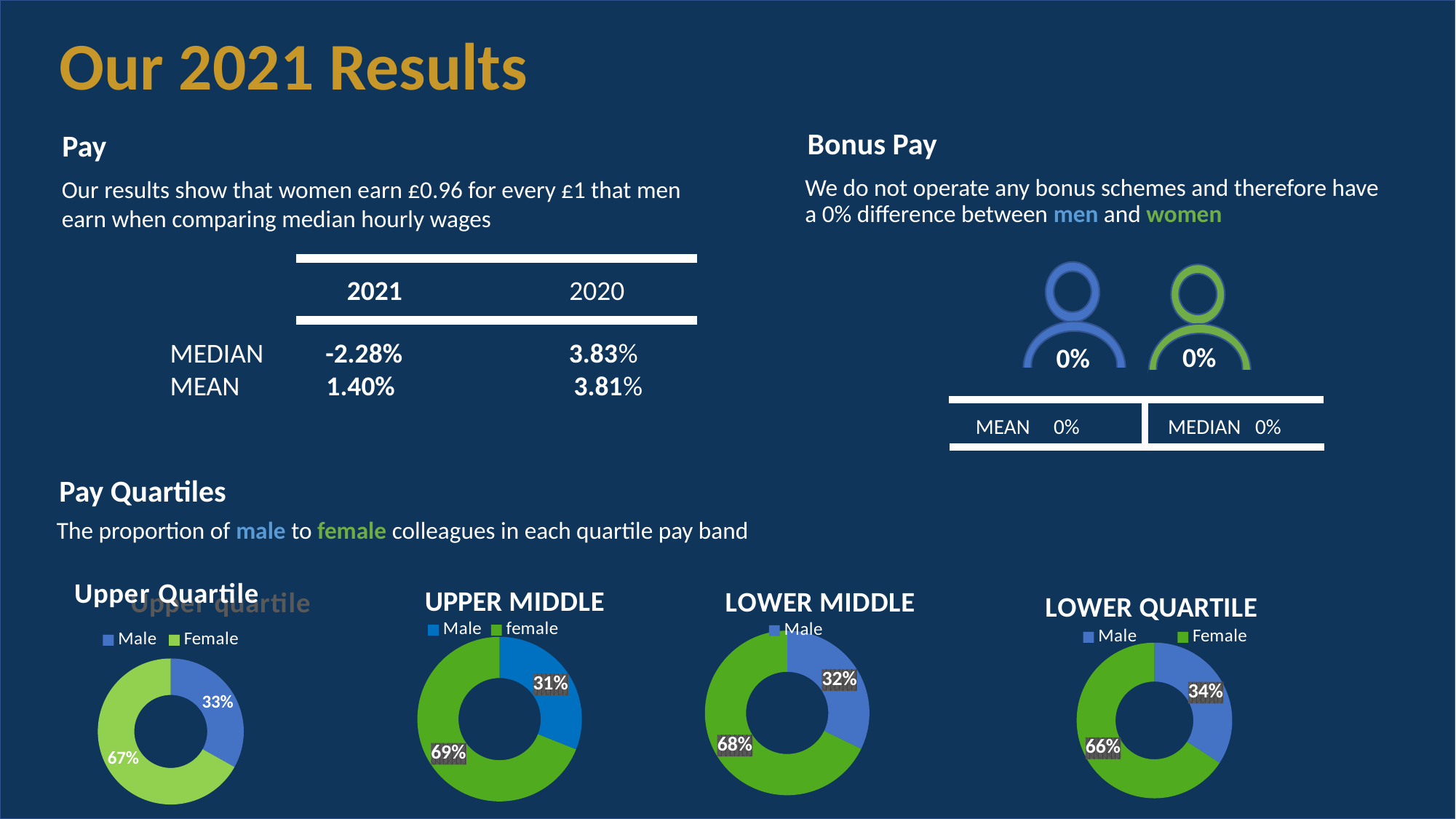
In the LOWER QUARTILE chart, what is the value for Male? 34% In the UPPER MIDDLE chart, what is the value for female? 69% In the LOWER MIDDLE chart, what is the value for Male? 32% In the LOWER QUARTILE chart, which is larger, Male or Female? Female What kind of chart is the UPPER MIDDLE chart? Doughnut chart In the UPPER MIDDLE chart, what is the value for Male? 31% In the UPPER MIDDLE chart, which slice is the largest? female In the Upper Quartile chart, what is the value for Male? 33% In the LOWER QUARTILE chart, what is the value for Female? 66% In the Upper Quartile chart, what is the value for Female? 67% How many series does the legend of the Upper Quartile chart list? 2 In the Upper Quartile chart, what is the difference between the Female and Male values? 34%